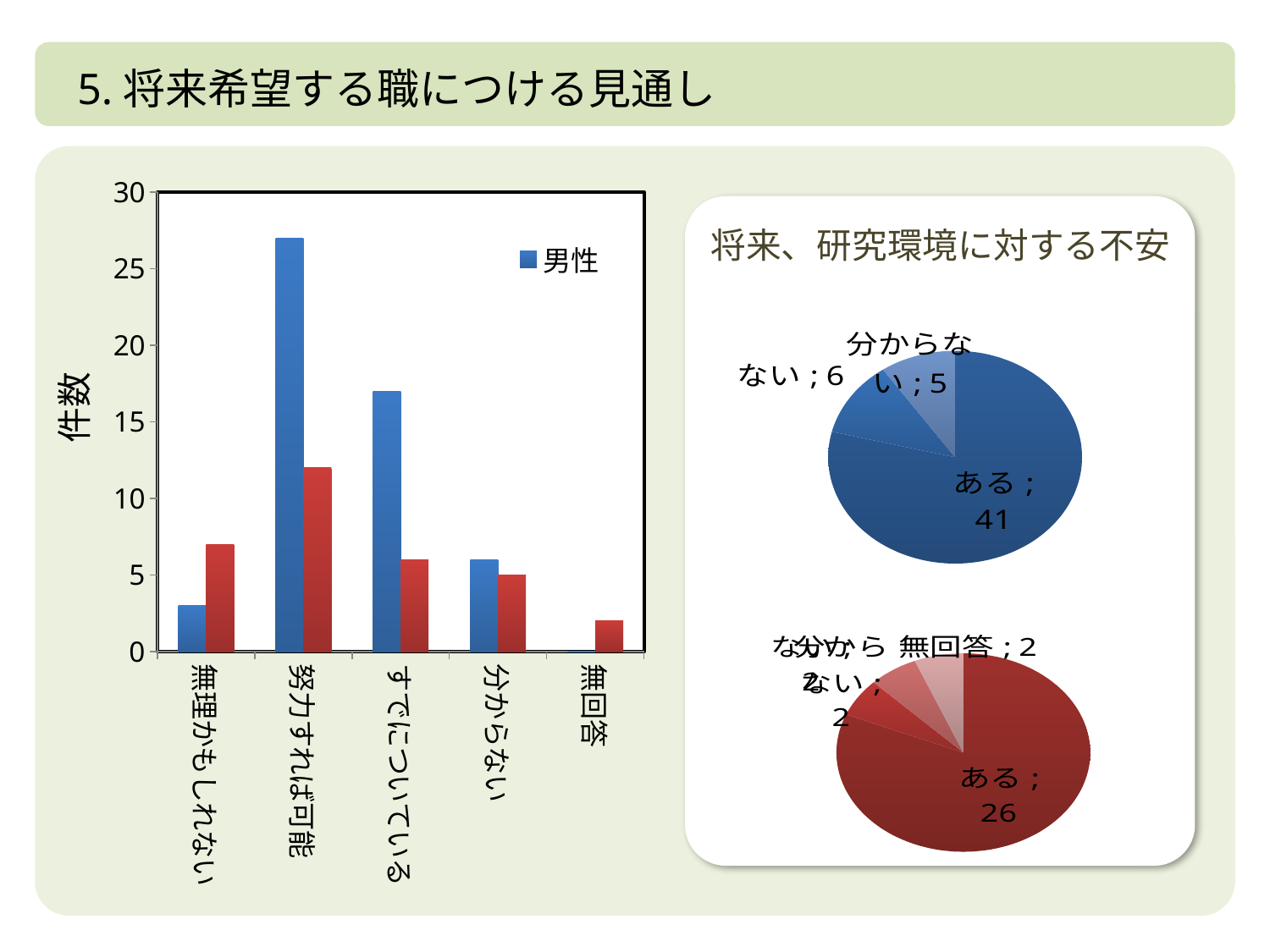
In the upper pie chart under 将来、研究環境に対する不安, what is the value for ある? 41 In the upper pie chart under 将来、研究環境に対する不安, what is the difference between the values for ある and 分からない? 36 What series name does the legend of the bar chart on the left show? 男性 In the bar chart on the left, which category has the highest 男性 value? 努力すれば可能 What kind of chart is the chart on the left of the slide? bar chart In the upper pie chart under 将来、研究環境に対する不安, which slice is the largest? ある In the lower pie chart under 将来、研究環境に対する不安, what is the value for ある? 26 In the upper pie chart under 将来、研究環境に対する不安, what is the value for ない? 6 In the bar chart on the left, is the 男性 value for 努力すれば可能 greater or less than 25? greater In the bar chart on the left, is the 男性 value for すでについている greater or less than 15? greater How many categories are shown on the x axis of the bar chart on the left? 5 In the bar chart on the left, which 男性 value is larger: 努力すれば可能 or すでについている? 努力すれば可能